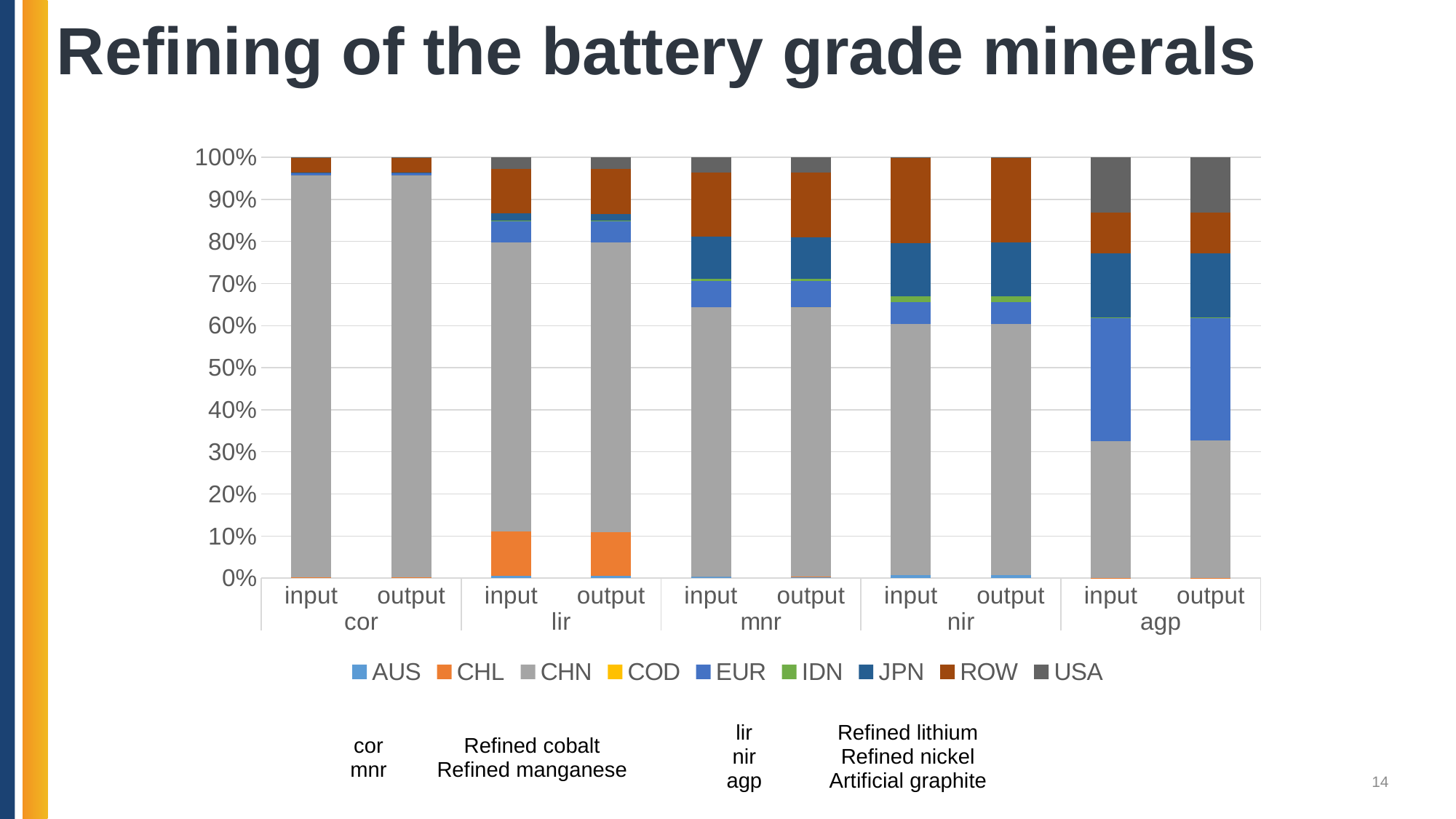
Is the EUR share of the agp input bar greater or less than 20%? greater Is the CHN share of the cor input bar greater or less than 90%? greater What kind of chart is shown on the slide? stacked bar chart Is the CHL share of the lir input bar greater or less than 5%? greater Which mineral group has the smallest CHN share? agp How many bars are plotted in the chart? 10 How many mineral groups are shown on the x axis? 5 Which mineral group has the largest CHN share? cor How many series does the legend list? 9 Which is larger, the CHN share of the cor input bar or the CHN share of the agp input bar? cor input